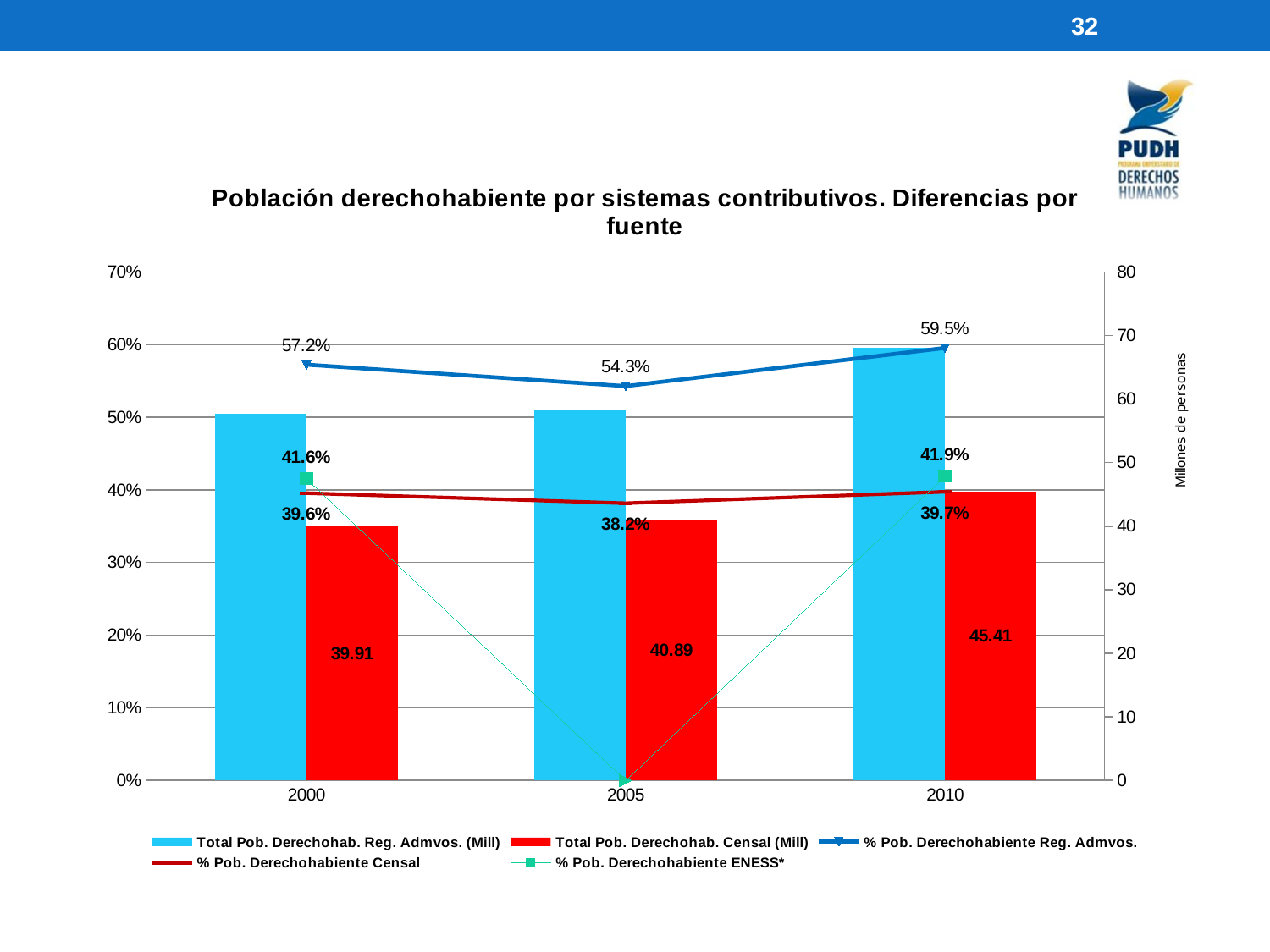
In which year is % Pob. Derechohabiente Reg. Admvos. lowest? 2005 What is the value of % Pob. Derechohabiente Censal for 2005? 38.2% How many years are shown on the x axis? 3 What is the title of the right-hand vertical axis? Millones de personas What is the value of Total Pob. Derechohab. Censal (Mill) for 2010? 45.41 What is the difference between Total Pob. Derechohab. Censal (Mill) in 2010 and in 2000? 5.50 Is the value of Total Pob. Derechohab. Reg. Admvos. (Mill) for 2010 greater or less than 60 on the right axis? greater In 2000, which is larger: % Pob. Derechohabiente Censal or % Pob. Derechohabiente ENESS*? % Pob. Derechohabiente ENESS* What is the difference between % Pob. Derechohabiente Reg. Admvos. in 2010 and in 2005? 5.2 percentage points In which year is Total Pob. Derechohab. Censal (Mill) highest? 2010 What is the value of % Pob. Derechohabiente Reg. Admvos. for 2005? 54.3% How many series does the legend list? 5